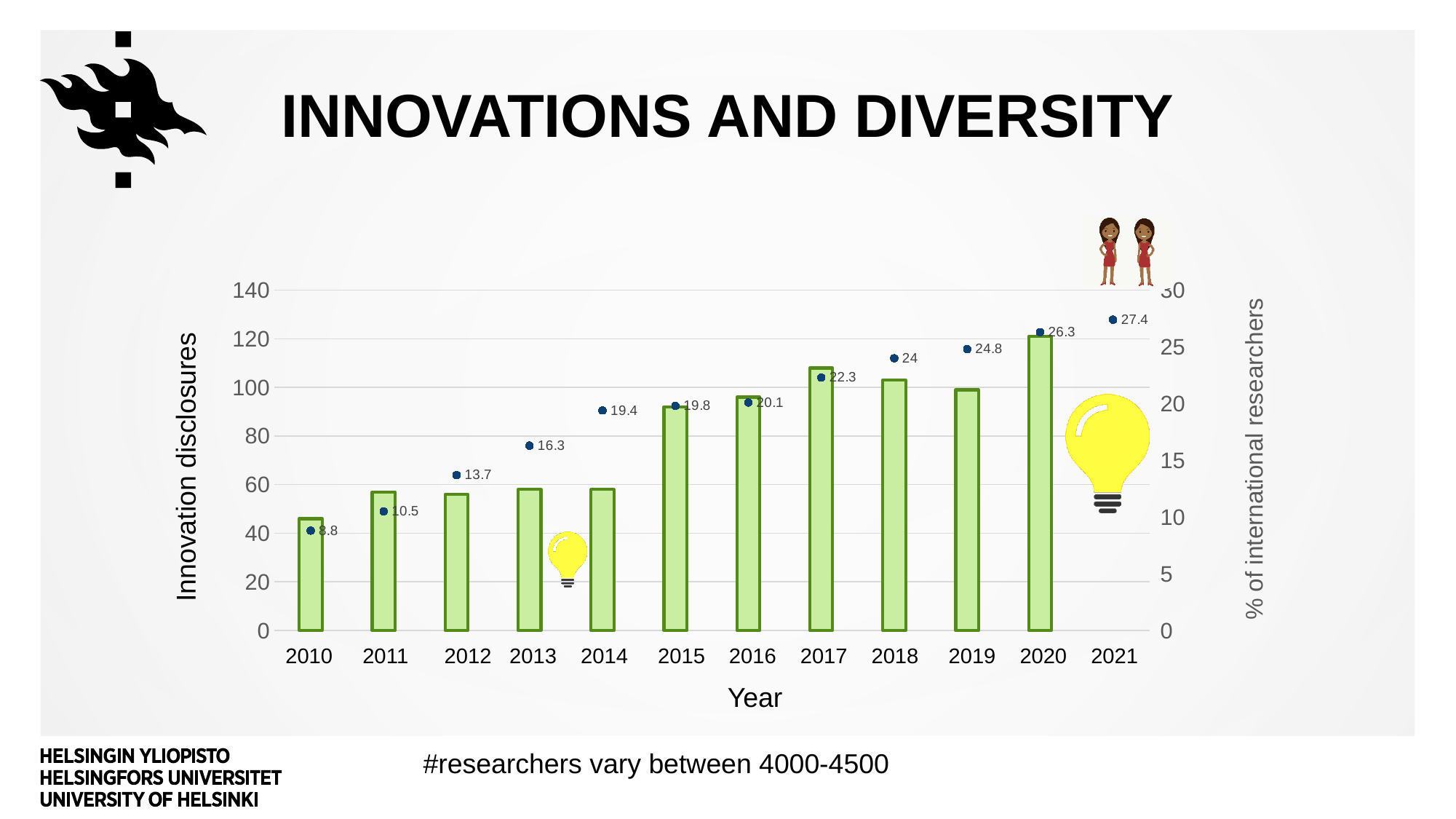
What is the % of international researchers in 2017? 22.3 Which year has a higher % of international researchers, 2018 or 2019? 2019 What is the % of international researchers in 2021? 27.4 By how much did the % of international researchers increase from 2010 to 2021? 18.6 What is the label of the left vertical axis? Innovation disclosures Is the number of innovation disclosures in 2010 greater or less than 60? less Which year has the lowest % of international researchers? 2010 Is the number of innovation disclosures in 2020 greater or less than 100? greater Does the % of international researchers rise or fall from 2010 to 2021? rise What is the % of international researchers in 2010? 8.8 Which year has the highest % of international researchers? 2021 Which year has the tallest innovation disclosures bar? 2020